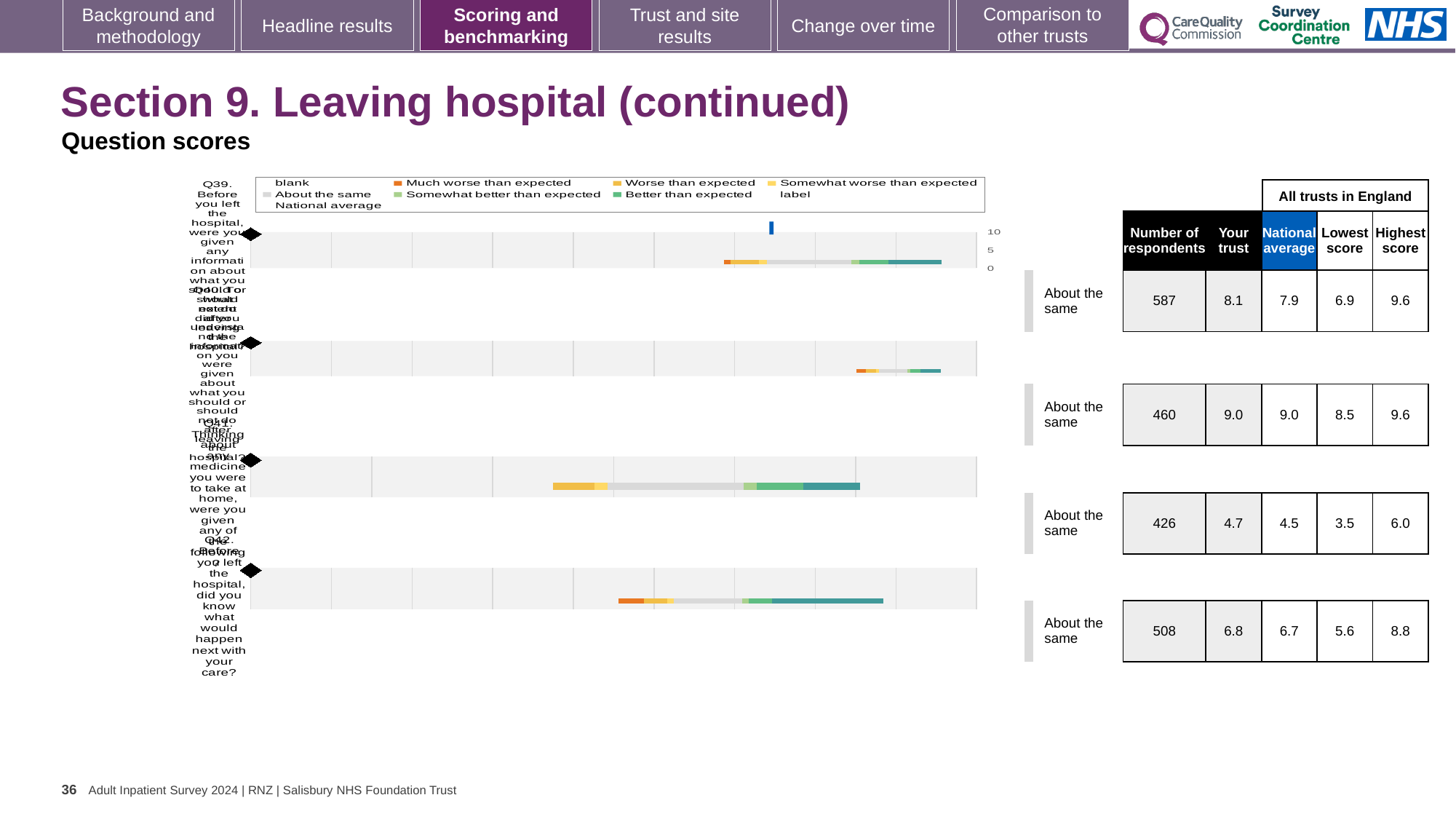
What kind of chart is shown on the slide? bar chart In the table beside the chart, what is the difference between the 'Your trust' score and the national average for the first row (Q39)? 0.2 In the table beside the chart, what is the number of respondents for the second row (Q40)? 460 How many question bars are plotted in the chart? 4 What is the benchmark category shown beside each of the four question bars? About the same In the table beside the chart, which row has the lowest 'Your trust' score? Q41 (4.7) Which legend entry is shown in orange? Much worse than expected Which legend entry is shown in dark teal? Better than expected In the table beside the chart, what is the national average for the fourth row (Q42)? 6.7 In the table beside the chart, what is the highest score for the third row (Q41)? 6.0 How many entries does the chart legend list? 9 In the table beside the chart, what is the 'Your trust' score for the first row (Q39)? 8.1